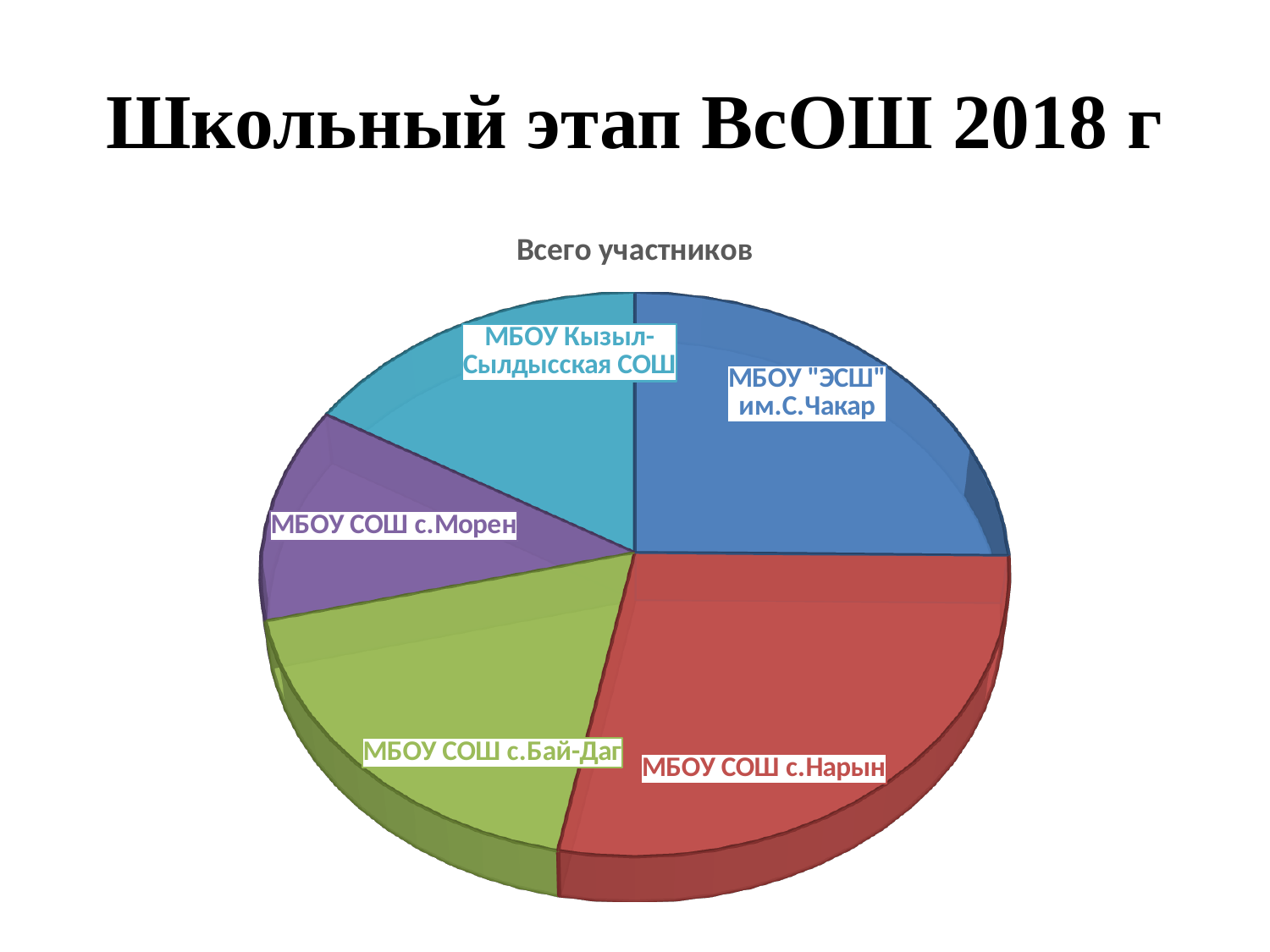
Which school has the smallest slice of the pie? МБОУ СОШ с.Морен What colour is the slice for МБОУ СОШ с.Нарын? red What kind of chart is shown on the slide? pie chart Which slice is larger: МБОУ Кызыл-Сылдысская СОШ or МБОУ СОШ с.Морен? МБОУ Кызыл-Сылдысская СОШ How many slices does the pie chart have? 5 Which slice is larger: МБОУ СОШ с.Нарын or МБОУ "ЭСШ" им.С.Чакар? МБОУ СОШ с.Нарын Which school has the largest slice of the pie? МБОУ СОШ с.Нарын Which slice is larger: МБОУ СОШ с.Бай-Даг or МБОУ СОШ с.Морен? МБОУ СОШ с.Бай-Даг What is the title of the chart? Всего участников